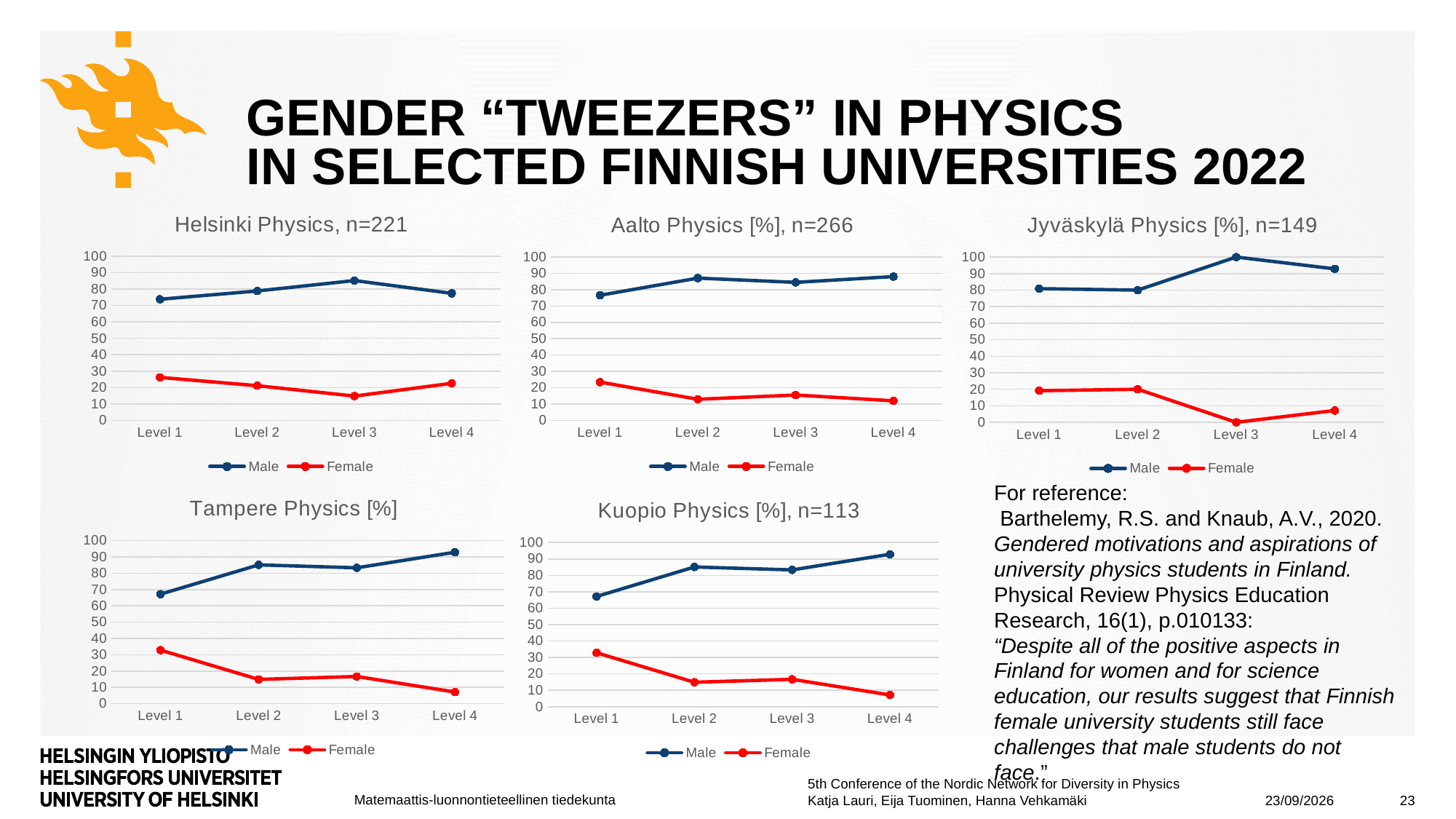
What colour is the Female line in the Helsinki Physics, n=221 chart? red In the Jyväskylä Physics [%], n=149 chart, at which level is the Male value highest? Level 3 In the Tampere Physics [%] chart, at which level is the Male value highest? Level 4 In the Jyväskylä Physics [%], n=149 chart, what is the Male value at Level 3? 100 How many series does the legend of the Aalto Physics [%], n=266 chart list? 2 How many levels are plotted along the x axis of the Kuopio Physics [%], n=113 chart? 4 In the Kuopio Physics [%], n=113 chart, does the Female line generally rise or fall from Level 1 to Level 4? fall In the Jyväskylä Physics [%], n=149 chart, at which level is the Female value lowest? Level 3 In the Aalto Physics [%], n=266 chart, which is larger at Level 1: the Male value or the Female value? Male What kind of chart is the Helsinki Physics, n=221 chart? line chart In the Helsinki Physics, n=221 chart, is the Male value at Level 3 greater or less than 80? greater In the Tampere Physics [%] chart, is the Female value at Level 4 greater or less than 10? less